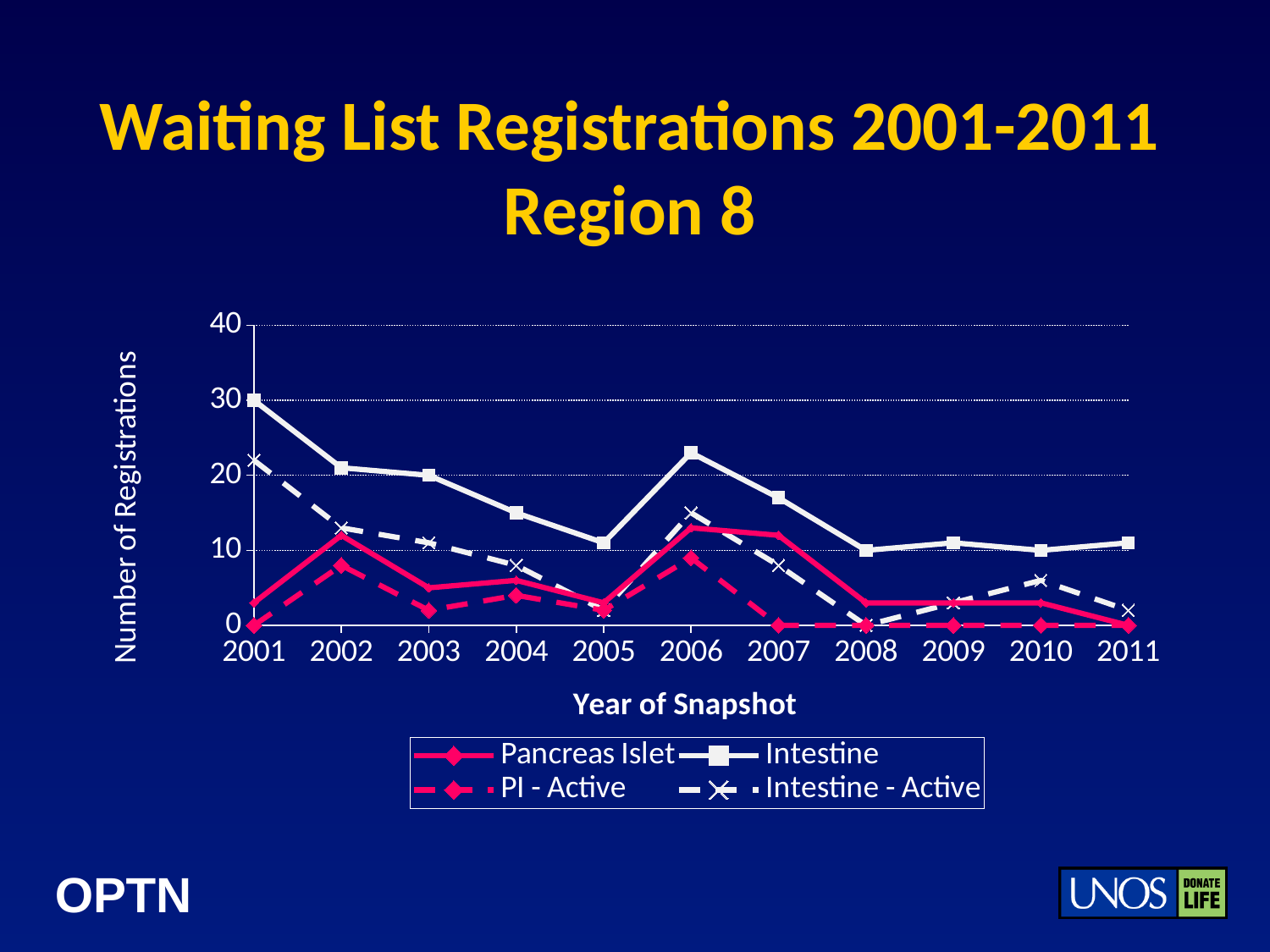
Is the value for Intestine in 2004 greater or less than 20? less In which year is the Intestine series at its highest? 2001 What type of chart is shown on the slide? line chart Does the Intestine series rise or fall from 2001 to 2005? fall What is the title of the x axis? Year of Snapshot How many years are plotted along the x axis? 11 Is the value for Pancreas Islet in 2002 greater or less than 10? greater In 2001, which is larger: Intestine or Pancreas Islet? Intestine What is the value for Intestine in 2001? 30 What is the value for PI - Active in 2001? 0 Is the value for Intestine in 2006 greater or less than 20? greater How many series does the legend list? 4